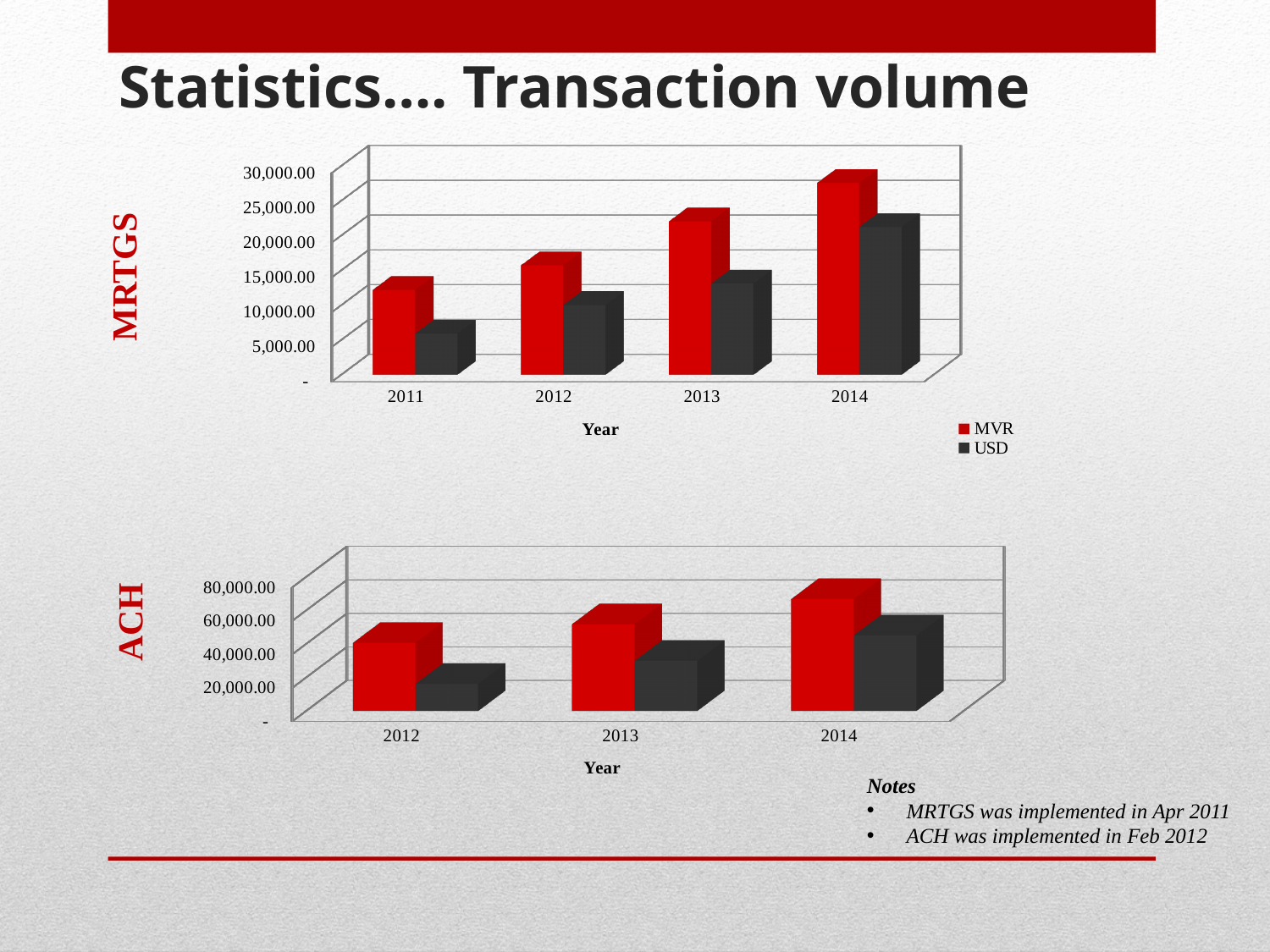
In the MRTGS chart, which year has the lowest USD value? 2011 What are the two legend entries of the MRTGS chart? MVR and USD In the MRTGS chart, do the MVR values rise or fall from 2011 to 2014? rise In the MRTGS chart, is the USD value for 2011 greater or less than 10,000.00? less How many series does the legend of the MRTGS chart list? 2 In the MRTGS chart, which year has the highest MVR value? 2014 In the MRTGS chart, which is larger in 2013, MVR or USD? MVR How many years are shown on the x axis of the MRTGS chart? 4 In the MRTGS chart, is the MVR value for 2014 greater or less than 25,000.00? greater What kind of chart is the MRTGS chart at the top of the slide? bar chart In the ACH chart, is the red bar for 2014 greater or less than 60,000.00? greater How many years are shown on the x axis of the ACH chart? 3